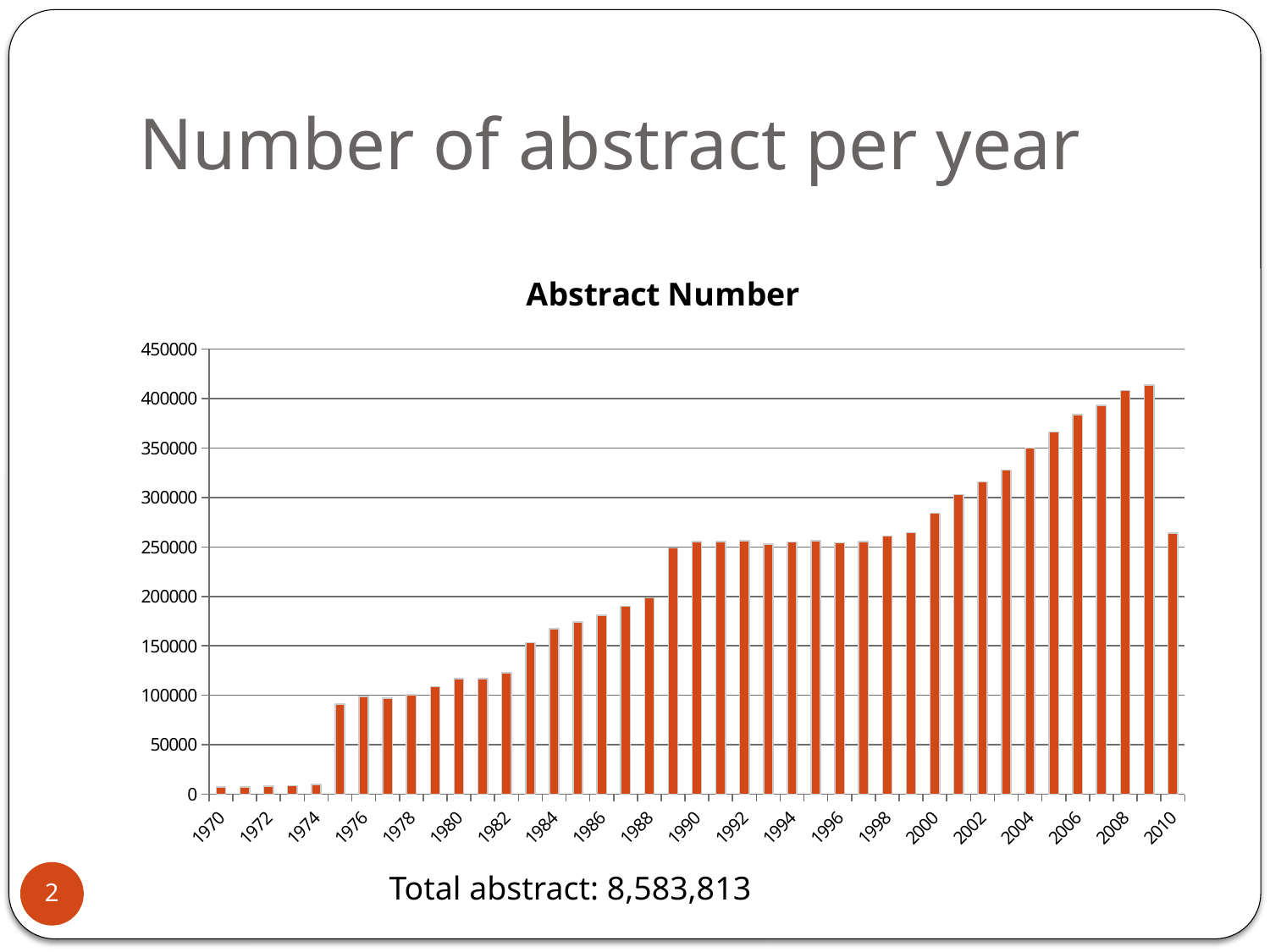
What kind of chart is shown on the slide? bar chart Is the value for 2010 greater or less than 250000? greater Is the value for 2005 greater or less than 350000? greater Which year has the larger value, 2009 or 2010? 2009 Which year has the highest number of abstracts? 2009 Is the value for 2009 greater or less than 400000? greater What total number of abstracts is stated below the chart? 8,583,813 Do the values generally rise or fall from 1975 to 2009? rise Which year has the larger value, 1980 or 1990? 1990 What is the title of the chart? Abstract Number